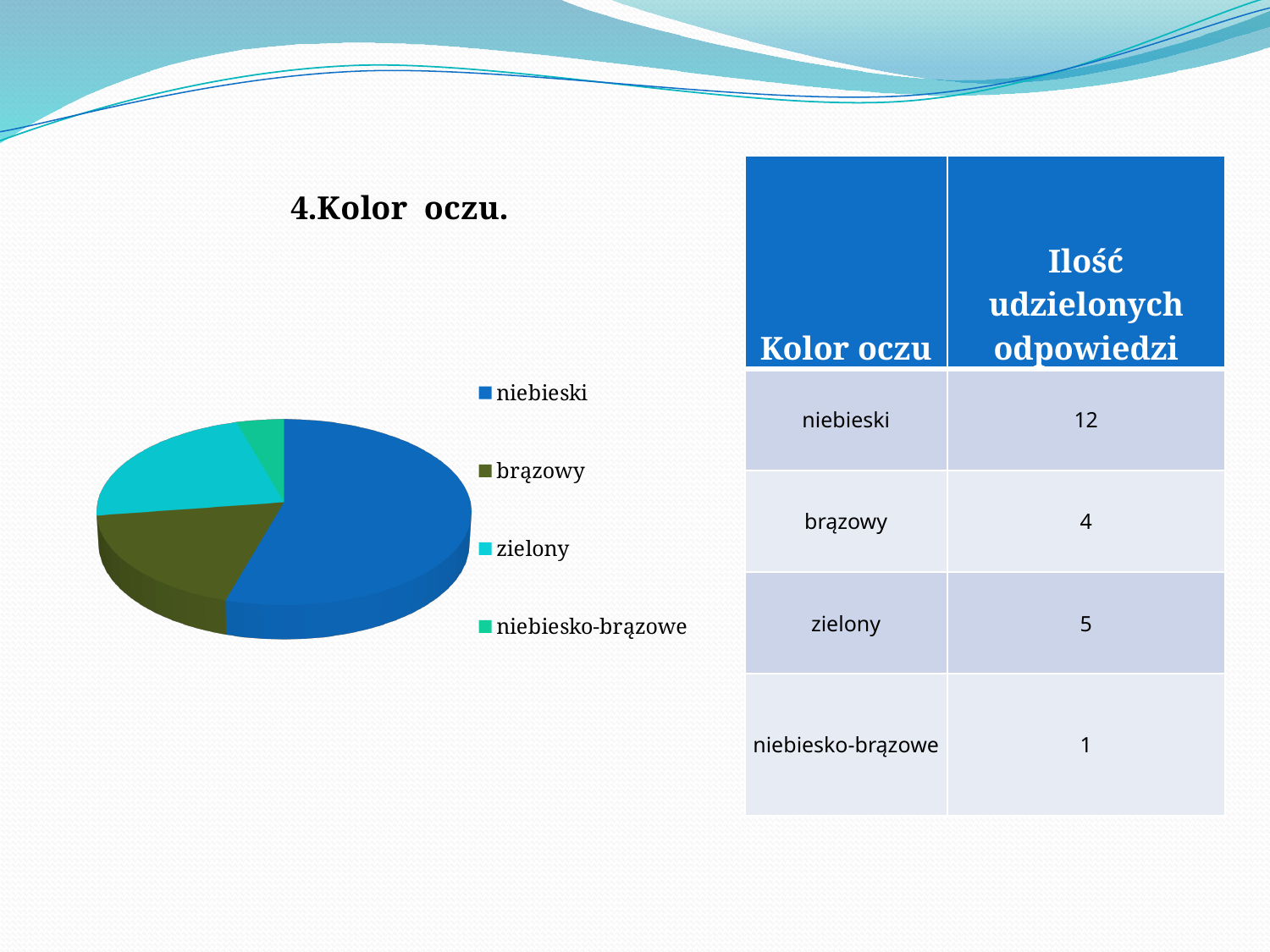
What is the title of the chart? 4.Kolor oczu. What is the difference between the number of responses for niebieski and brązowy? 8 How many responses were given for brązowy according to the table? 4 Which eye colour has the smallest slice in the pie chart? niebiesko-brązowe How many categories (slices) does the pie chart have? 4 How many responses were given for niebieski according to the table? 12 What kind of chart is shown on the slide? pie chart Which has more responses, zielony or brązowy? zielony Which eye colour has the largest slice in the pie chart? niebieski What is the total number of responses across all four eye colours? 22 How many responses were given for zielony according to the table? 5 How many responses were given for niebiesko-brązowe according to the table? 1